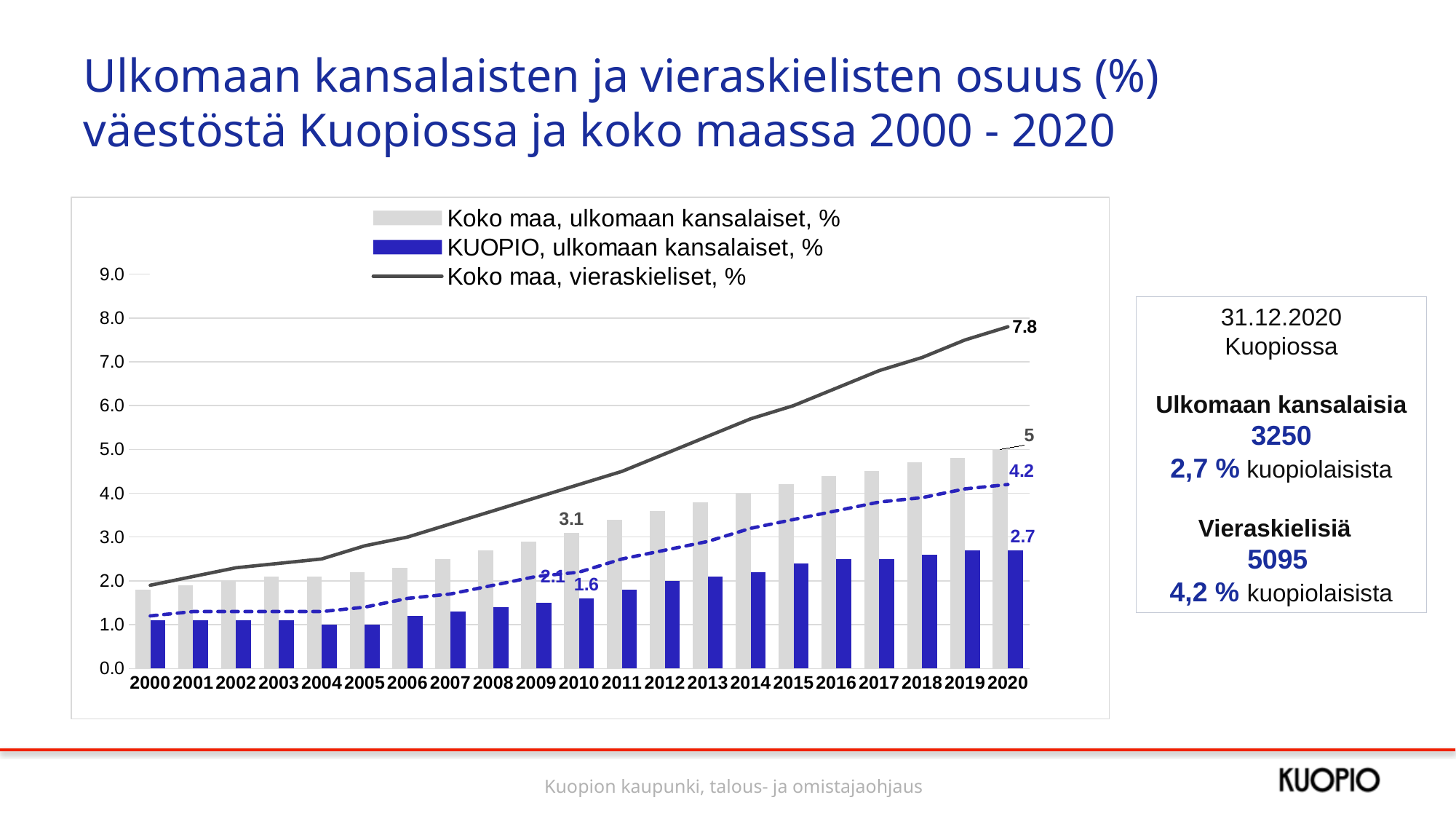
What is the value for KUOPIO, ulkomaan kansalaiset, % in 2010? 1.6 Which is larger in 2020: Koko maa, ulkomaan kansalaiset, % or KUOPIO, ulkomaan kansalaiset, %? Koko maa, ulkomaan kansalaiset, % What is the value for Koko maa, ulkomaan kansalaiset, % in 2010? 3.1 Does the Koko maa, vieraskieliset, % line rise or fall from 2000 to 2020? rise How many years are shown on the x axis? 21 Is the value for KUOPIO, ulkomaan kansalaiset, % in 2000 greater or less than 2.0? less What is the difference between Koko maa, ulkomaan kansalaiset, % and KUOPIO, ulkomaan kansalaiset, % in 2020? 2.3 What is the value for Koko maa, ulkomaan kansalaiset, % in 2020? 5 How many series does the legend list? 3 What is the value for Koko maa, vieraskieliset, % in 2020? 7.8 What is the value for KUOPIO, ulkomaan kansalaiset, % in 2020? 2.7 What is the difference between Koko maa, ulkomaan kansalaiset, % and KUOPIO, ulkomaan kansalaiset, % in 2010? 1.5